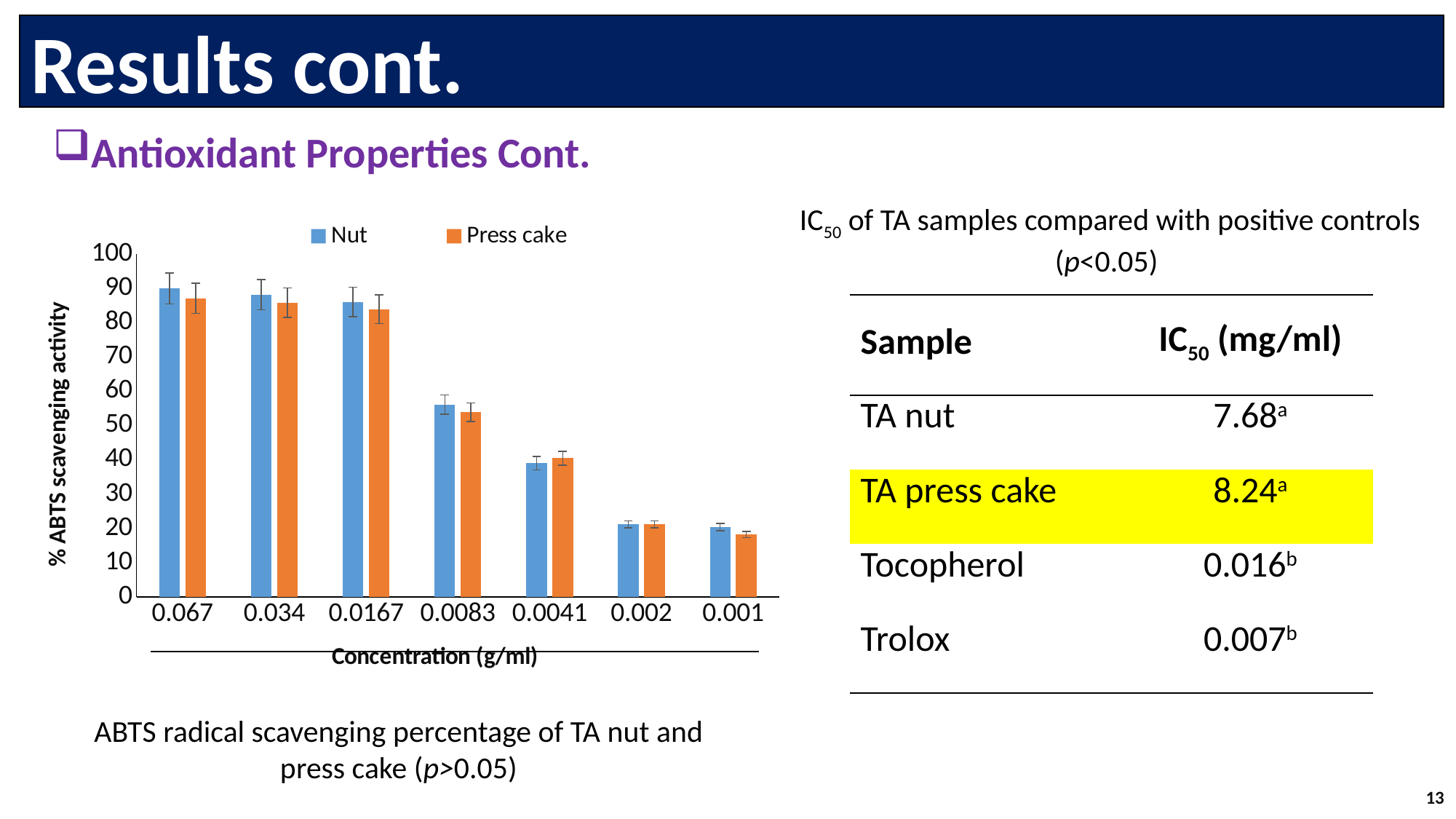
Is the Press cake value at concentration 0.0083 greater or less than 60? less What is the title of the chart's y axis? % ABTS scavenging activity Do the values rise or fall moving from left to right along the x axis? fall How many series does the chart's legend list? 2 Is the Nut value at concentration 0.001 greater or less than 10? greater At which concentration is the Press cake bar lowest? 0.001 Is the Nut value at concentration 0.0041 greater or less than 50? less What kind of chart is shown on the slide? bar chart How many concentration categories are shown on the x axis of the chart? 7 Which is larger: the Nut value at 0.0083 or the Nut value at 0.0041? Nut at 0.0083